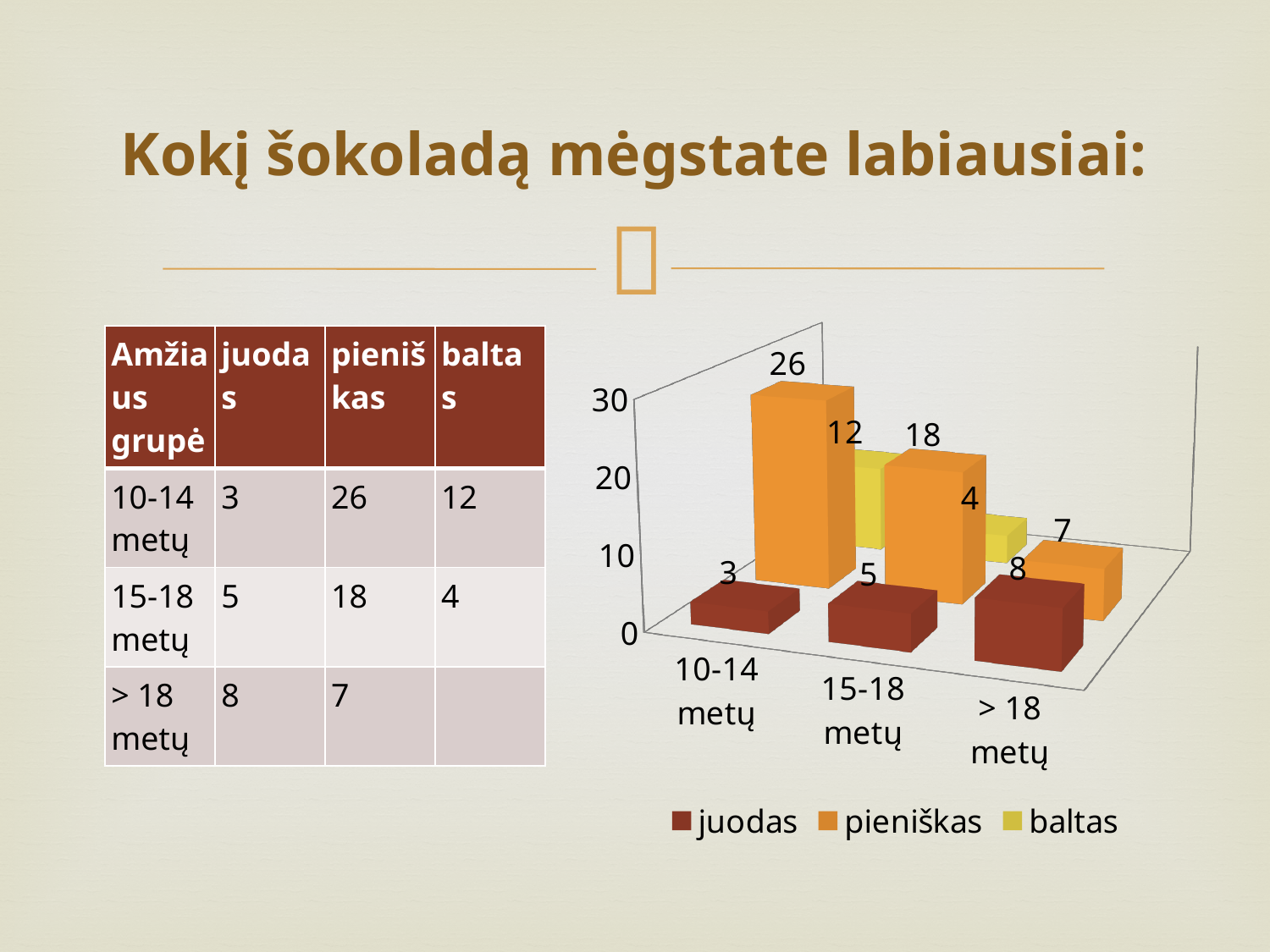
Do the pieniškas values rise or fall across the age groups from 10-14 metų to > 18 metų? fall What is the value for baltas in the 15-18 metų group? 4 What type of chart is shown on the slide? bar chart How many age-group categories are shown on the chart's x axis? 3 Which age group has the lowest value for juodas? 10-14 metų What is the difference between the pieniškas values for 10-14 metų and 15-18 metų? 8 Which age group has the highest value for pieniškas? 10-14 metų What is the value for juodas in the > 18 metų group? 8 How many series does the chart legend list? 3 What is the value for pieniškas in the 10-14 metų group? 26 Which series is shown in yellow in the chart legend? baltas Which is larger in the > 18 metų group, juodas or pieniškas? juodas